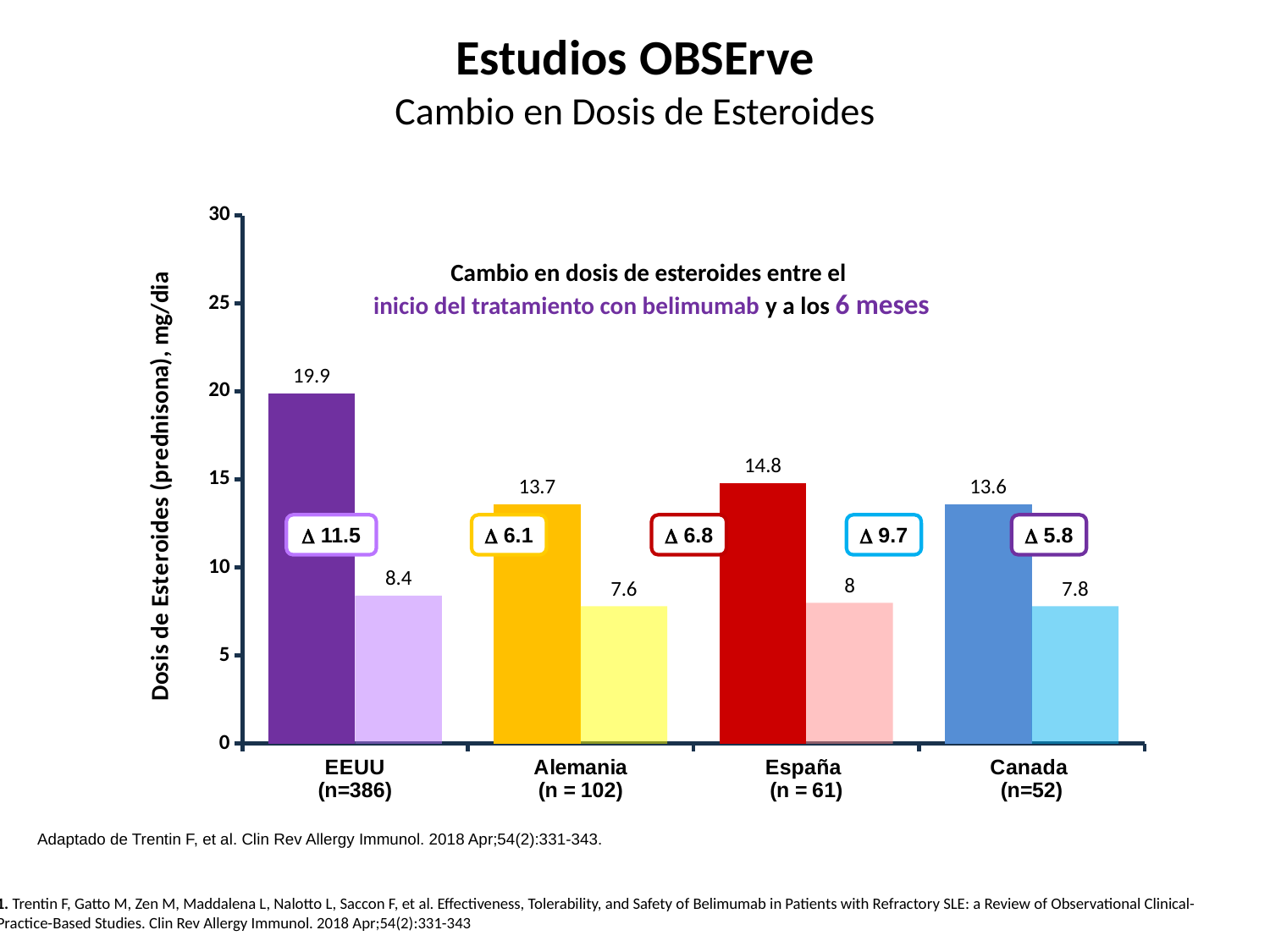
What is the steroid dose for Alemania at 6 months? 7.6 Which is larger: the starting dose for España or the starting dose for Alemania? España Is the starting dose for EEUU greater or less than 15? greater How many countries are shown on the x axis? 4 What is the label of the y axis? Dosis de Esteroides (prednisona), mg/dia What is the difference between the EEUU dose at the start of treatment (19.9) and at 6 months (8.4)? 11.5 What kind of chart is shown on the slide? bar chart What is the steroid dose for España at the start of treatment? 14.8 What is the steroid dose for Canada at 6 months? 7.8 What is the steroid dose for EEUU at the start of belimumab treatment? 19.9 Which country has the lowest steroid dose at 6 months? Alemania Which country has the highest steroid dose at the start of treatment? EEUU